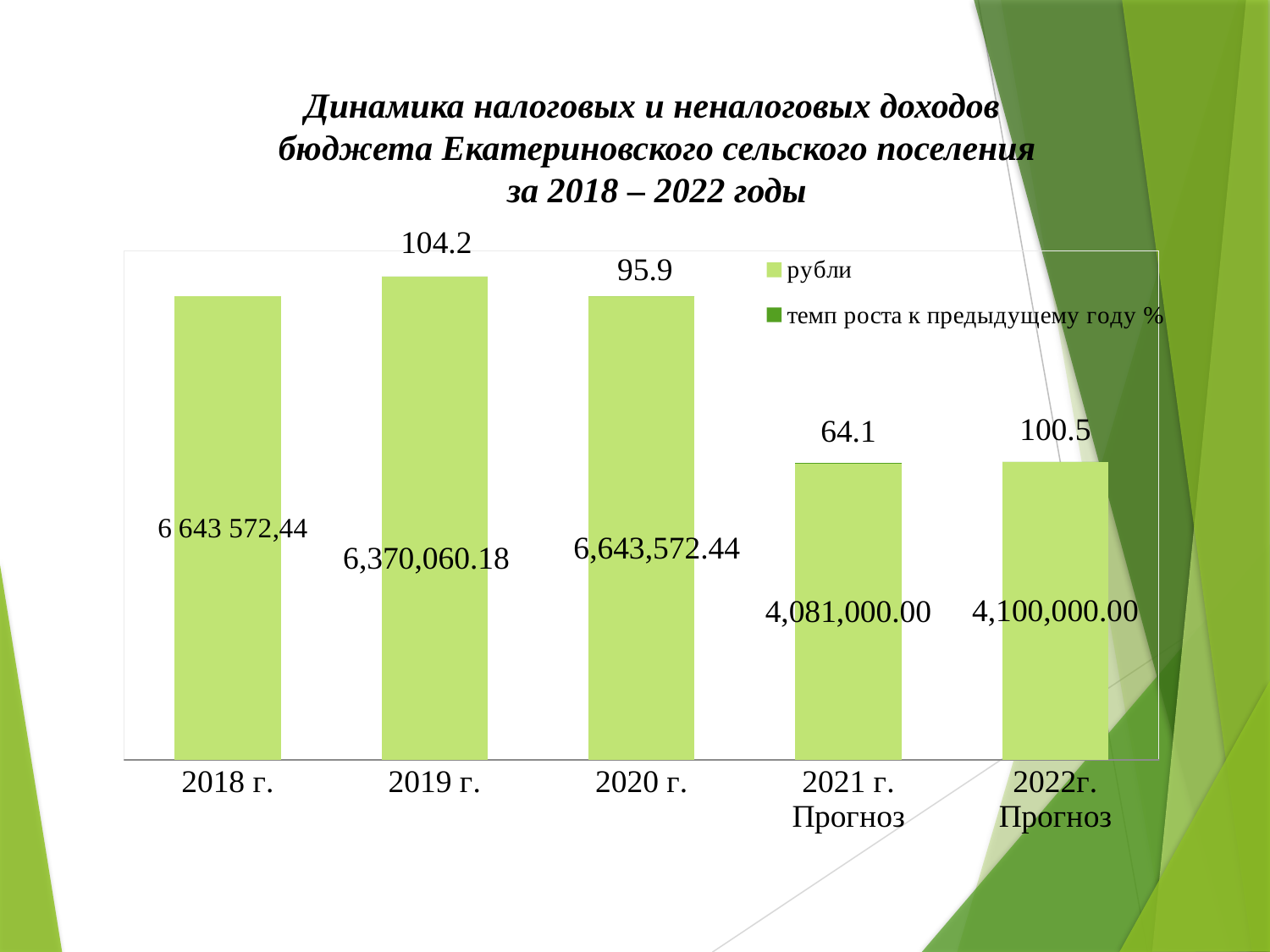
Which is larger in rubles: 2019 г. or 2021 г. Прогноз? 2019 г. How many categories are shown on the x axis? 5 Which year has the highest growth rate to the previous year? 2019 г. Which category has the lowest value in rubles? 2021 г. Прогноз What is the growth rate to the previous year (темп роста) shown for 2022г. Прогноз? 100.5 What is the value in rubles for 2021 г. Прогноз? 4,081,000.00 What is the difference in rubles between 2022г. Прогноз and 2021 г. Прогноз? 19,000.00 What is the growth rate to the previous year (темп роста) shown for 2020 г.? 95.9 What is the difference between the growth rates for 2019 г. and 2020 г.? 8.3 How many series does the legend list? 2 What kind of chart is shown on the slide? bar chart What is the value in rubles for 2019 г.? 6,370,060.18